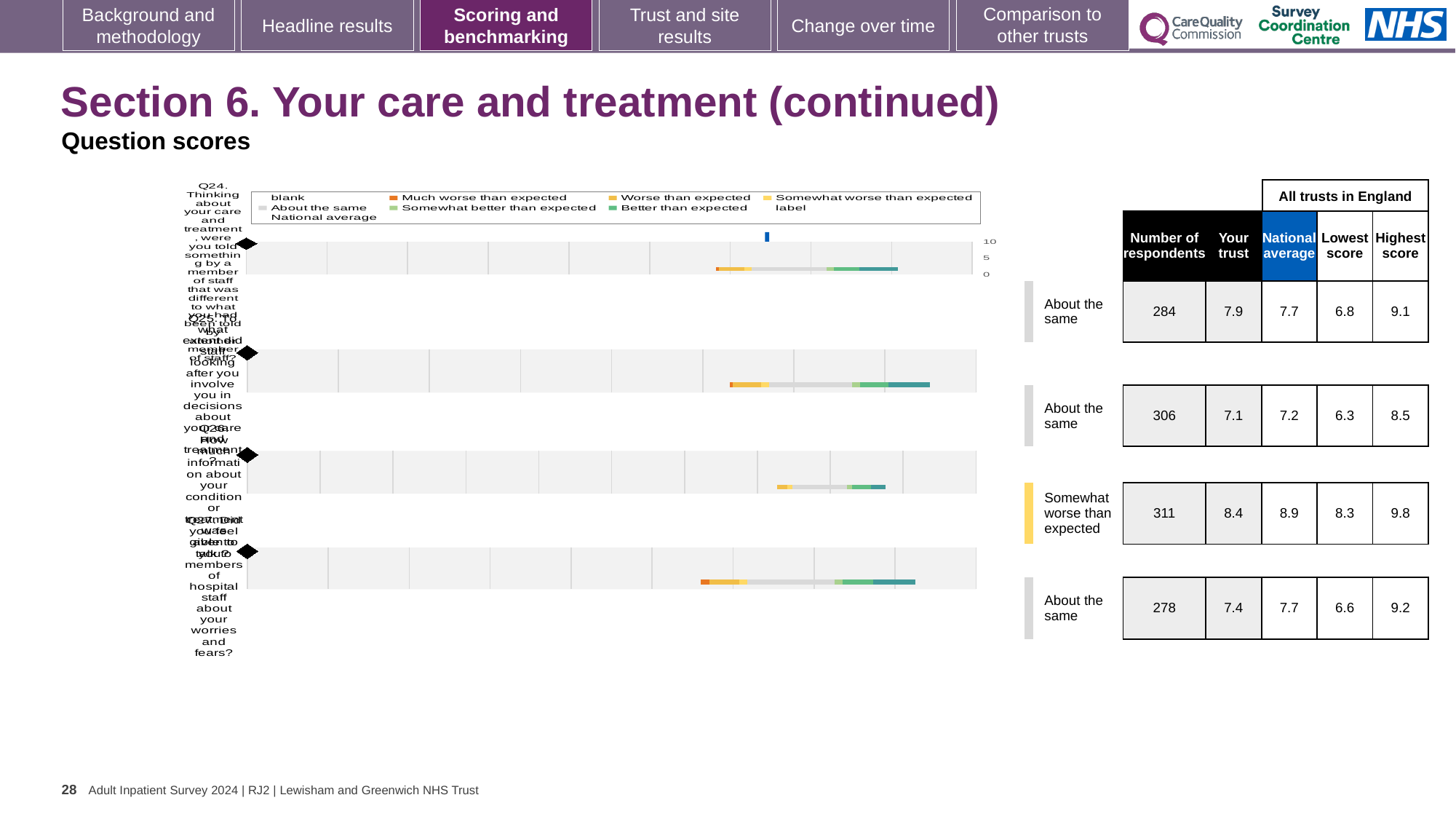
For the third chart (Q26), how many respondents are listed? 311 Which question (Q24 to Q27) has the highest 'Your trust' score? Q26 For the first chart (Q24), which is larger: the 'Your trust' score or the national average? Your trust For the second chart (Q25), what is the national average score? 7.2 For the fourth chart (Q27), what is the highest score among all trusts in England? 9.2 How many question score charts are shown on the slide? 4 For the second chart (Q25), what is the lowest score among all trusts in England? 6.3 What kind of chart is used to show the question scores on this slide? bar chart What benchmark category is shown for the third chart (Q26)? Somewhat worse than expected Which question (Q24 to Q27) has the lowest 'Your trust' score? Q25 For the third chart (Q26), what is the difference between the national average and the 'Your trust' score? 0.5 For the first chart (Q24), what is the 'Your trust' score shown in the table? 7.9